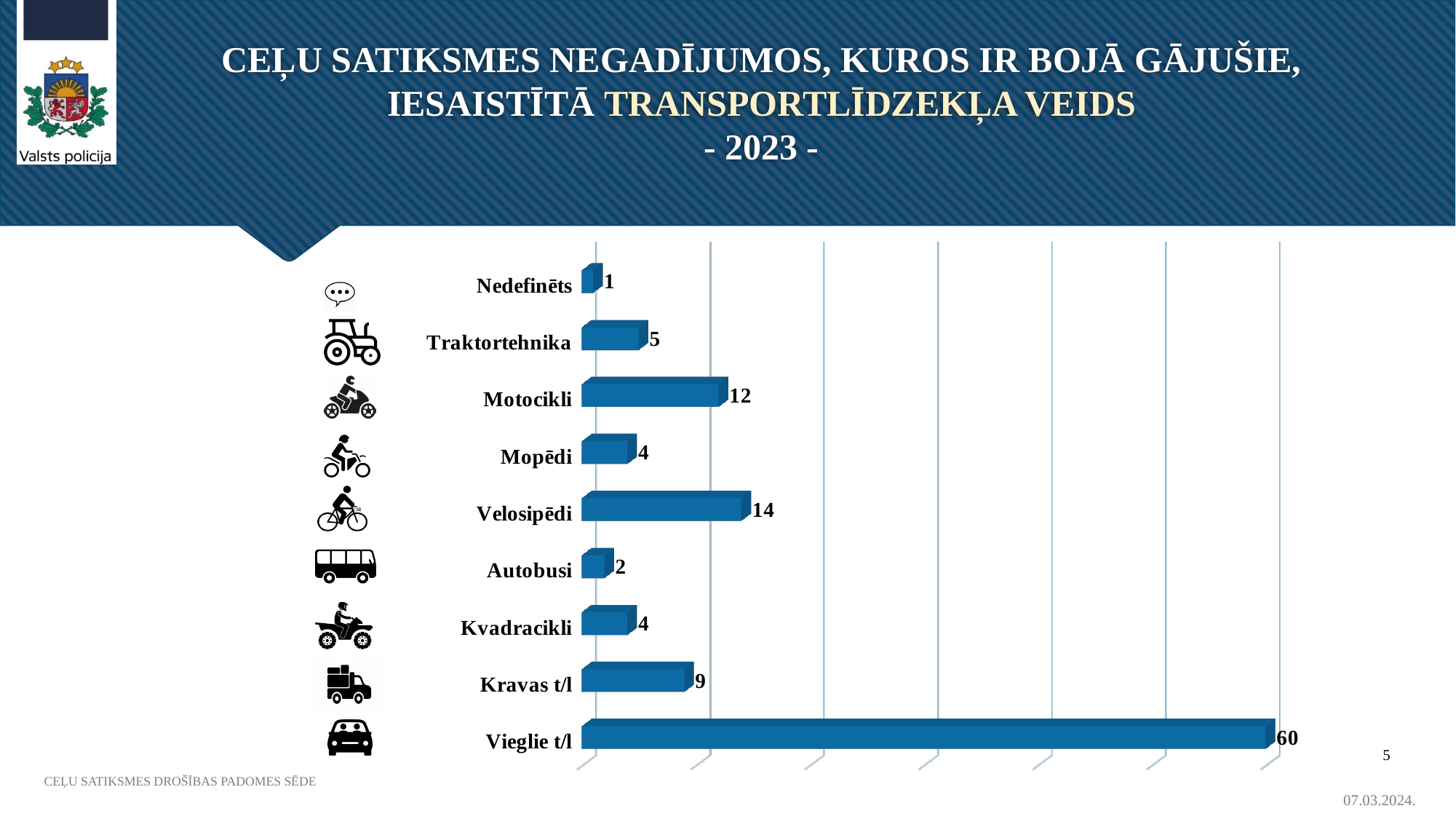
Which category has the highest value? Vieglie t/l What is the value for Traktortehnika? 5 What kind of chart is shown on the slide? bar chart What is the value for Velosipēdi? 14 Which category has the lowest value? Nedefinēts What is the difference between the values for Vieglie t/l and Velosipēdi? 46 What is the value for Motocikli? 12 Which is larger, the value for Motocikli or the value for Kravas t/l? Motocikli Which two categories both have a value of 4? Mopēdi and Kvadracikli What is the value for Vieglie t/l? 60 What is the difference between the values for Kravas t/l and Autobusi? 7 How many categories are shown in the chart? 9